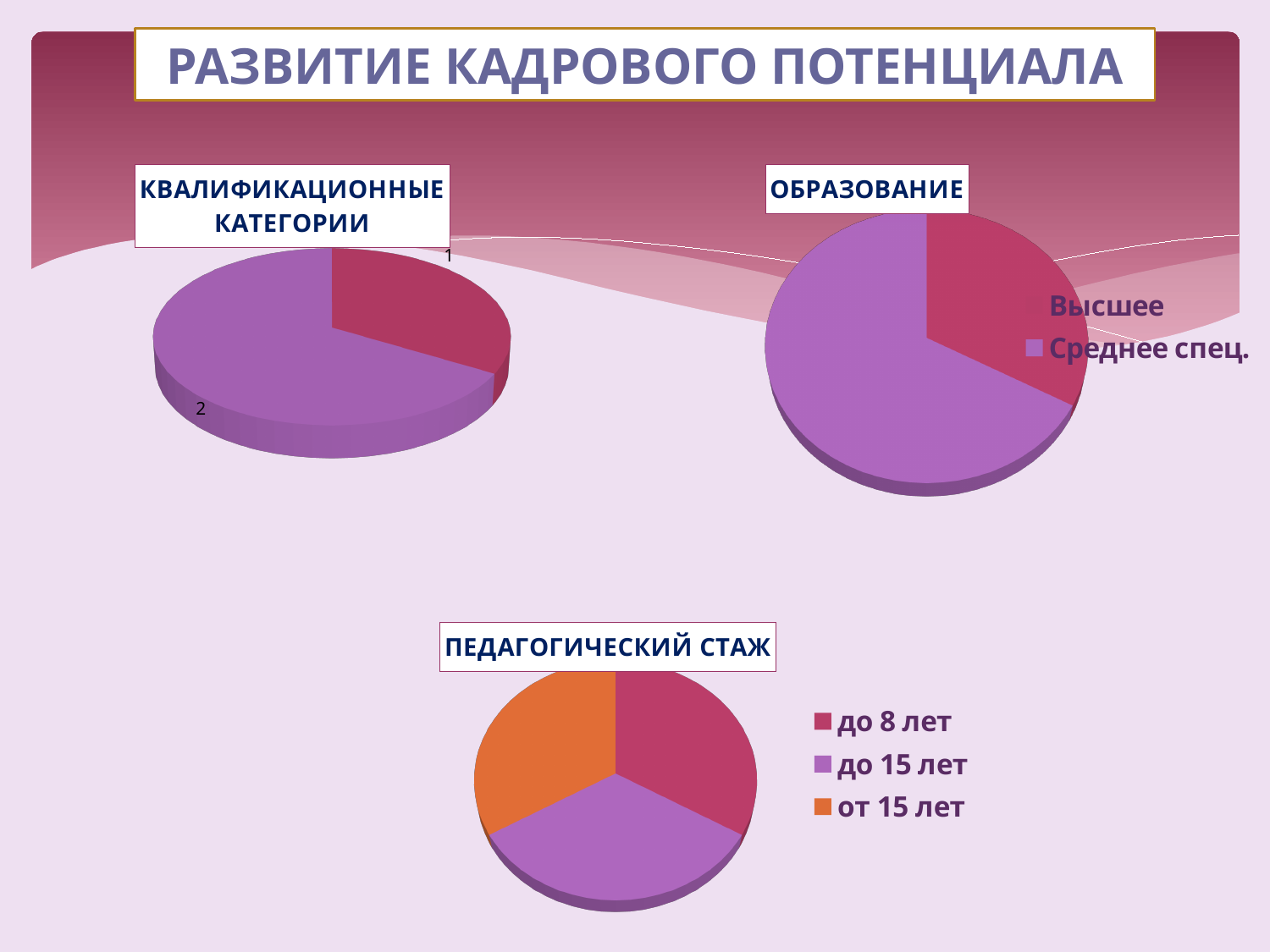
How many entries does the legend of the "ОБРАЗОВАНИЕ" chart list? 2 In the "ОБРАЗОВАНИЕ" chart, which category has the largest slice? Среднее спец. How many slices does the "ОБРАЗОВАНИЕ" pie chart have? 2 In the "ПЕДАГОГИЧЕСКИЙ СТАЖ" chart, which legend entry is shown in orange? от 15 лет What kind of chart is the "ПЕДАГОГИЧЕСКИЙ СТАЖ" chart? pie chart In the "КВАЛИФИКАЦИОННЫЕ КАТЕГОРИИ" chart, which slice is larger, 1 or 2? 2 In the "ОБРАЗОВАНИЕ" chart, which category has the smallest slice? Высшее How many pie charts are shown on the slide? 3 How many slices does the "КВАЛИФИКАЦИОННЫЕ КАТЕГОРИИ" pie chart have? 2 How many entries does the legend of the "ПЕДАГОГИЧЕСКИЙ СТАЖ" chart list? 3 What kind of chart is the "ОБРАЗОВАНИЕ" chart? pie chart How many slices does the "ПЕДАГОГИЧЕСКИЙ СТАЖ" pie chart have? 3